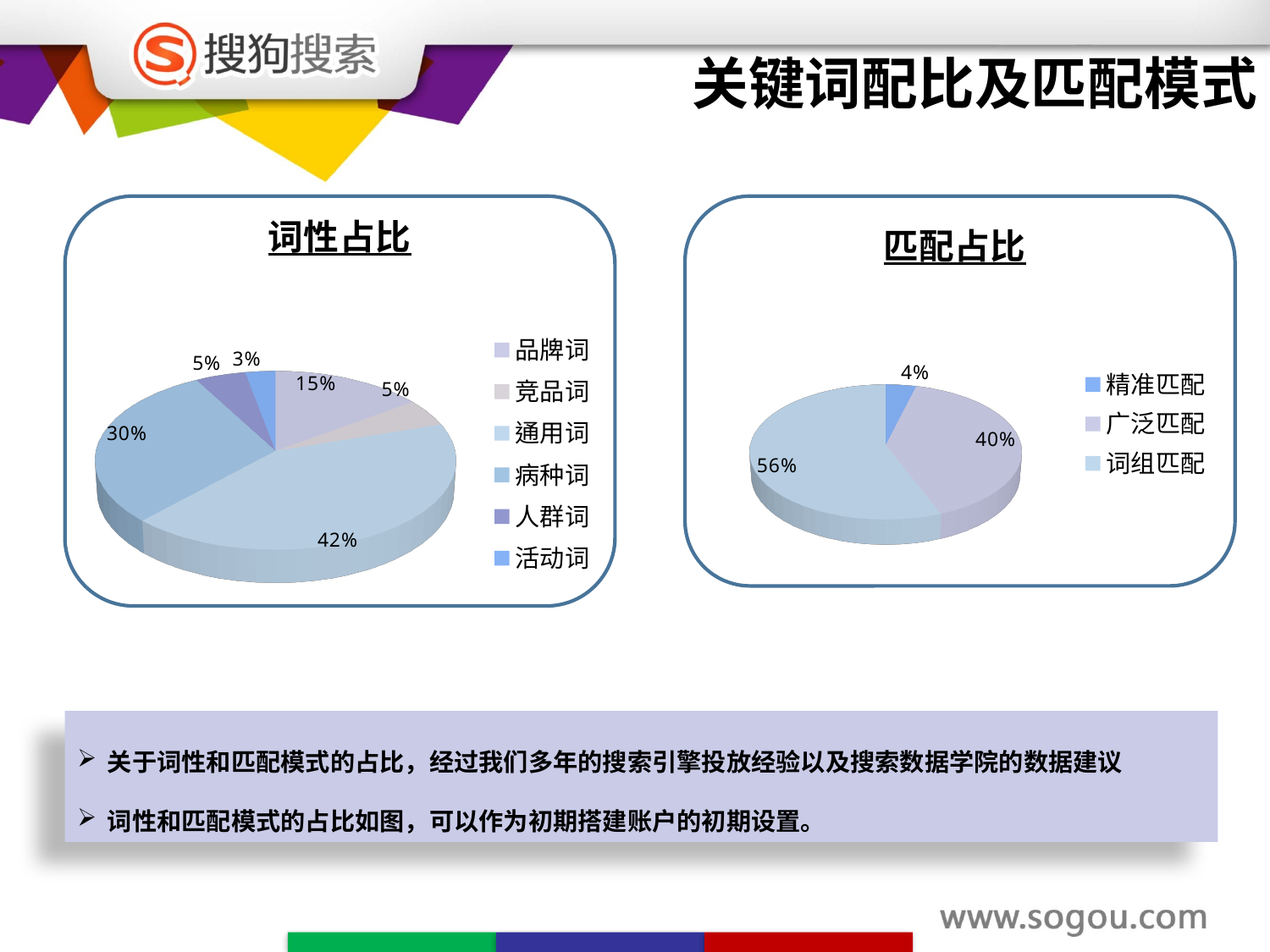
In the 词性占比 chart, which category has the largest share? 通用词 In the 词性占比 chart, what is the difference between the shares of 通用词 and 病种词? 12% What kind of chart is the 匹配占比 chart? Pie chart In the 匹配占比 chart, which is larger, 广泛匹配 or 词组匹配? 词组匹配 In the 词性占比 chart, what share does 品牌词 have? 15% In the 匹配占比 chart, how many categories does the legend list? 3 In the 词性占比 chart, which category has the smallest share? 活动词 In the 匹配占比 chart, what share does 词组匹配 have? 56% In the 词性占比 chart, how many categories does the legend list? 6 In the 词性占比 chart, what share does 病种词 have? 30% In the 匹配占比 chart, what share does 精准匹配 have? 4% In the 词性占比 chart, what share does 通用词 have? 42%